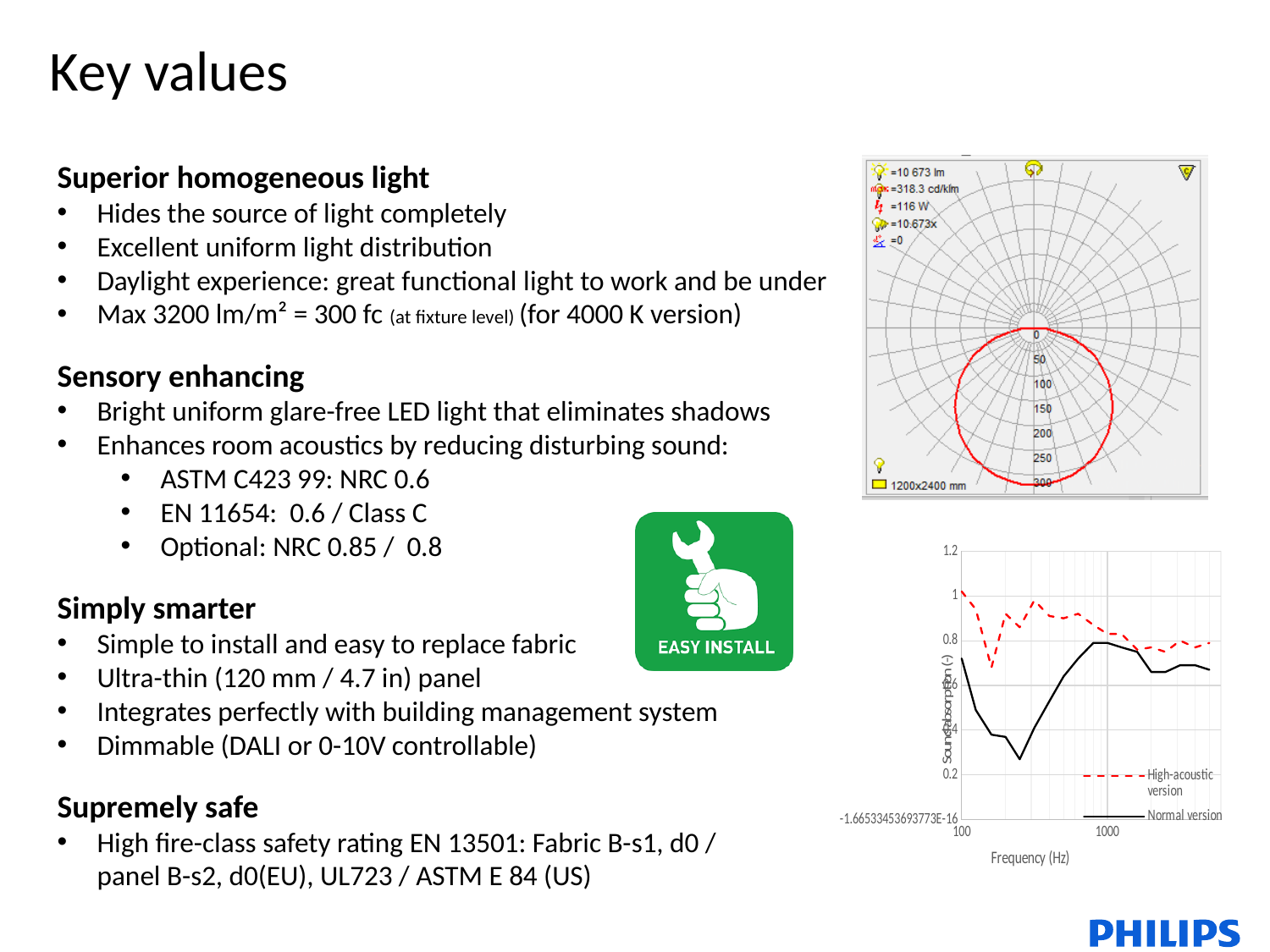
In the sound absorption chart, which series stays higher across the whole frequency range? High-acoustic version In the sound absorption chart, is the lowest value of the Normal version greater or less than 0.4? less What is the x-axis title of the sound absorption chart? Frequency (Hz) How many series does the legend of the sound absorption chart list? 2 In the sound absorption chart, is the High-acoustic version's sound absorption at 100 Hz greater or less than 0.8? greater In the sound absorption chart, is the Normal version's sound absorption at 100 Hz greater or less than 0.6? greater What kind of chart is the sound absorption chart at the bottom right of the slide? line chart In the sound absorption chart, which series is drawn with a red dashed line? High-acoustic version In the sound absorption chart, which series has the higher sound absorption at 100 Hz, the High-acoustic version or the Normal version? High-acoustic version In the sound absorption chart, does the Normal version's sound absorption rise or fall between 100 Hz and about 200 Hz? fall